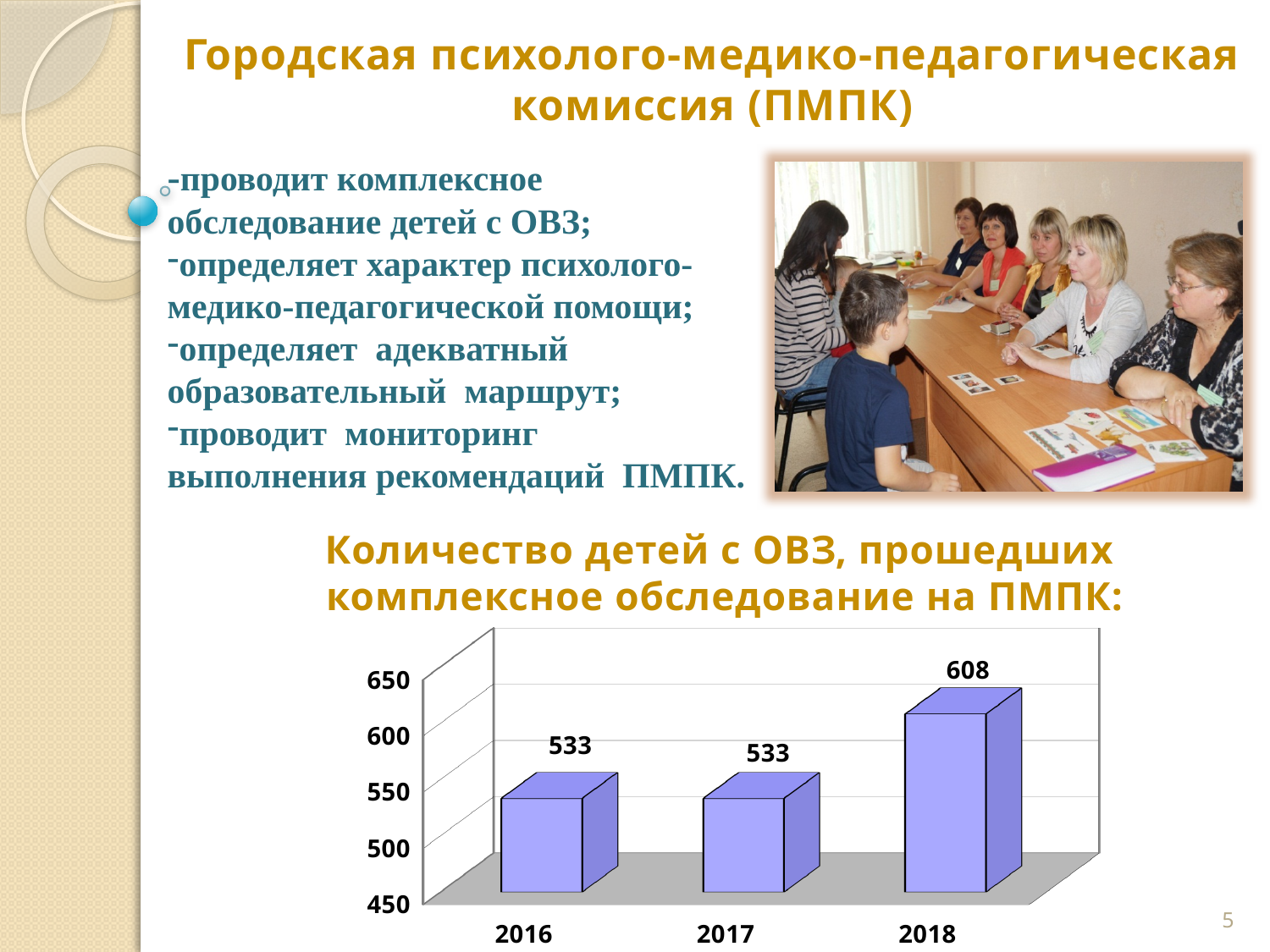
What is the value for 2016? 533 Is the value for 2016 greater or less than 550? less How many years are shown on the x axis? 3 What is the title of the chart? Количество детей с ОВЗ, прошедших комплексное обследование на ПМПК: Which is larger, the value for 2016 or the value for 2018? 2018 What kind of chart is shown on the slide? bar chart Is the value for 2018 greater or less than 600? greater What is the value for 2018? 608 What is the difference between the values for 2018 and 2017? 75 Do the values rise or fall from 2017 to 2018? rise What is the value for 2017? 533 Which year has the highest value? 2018